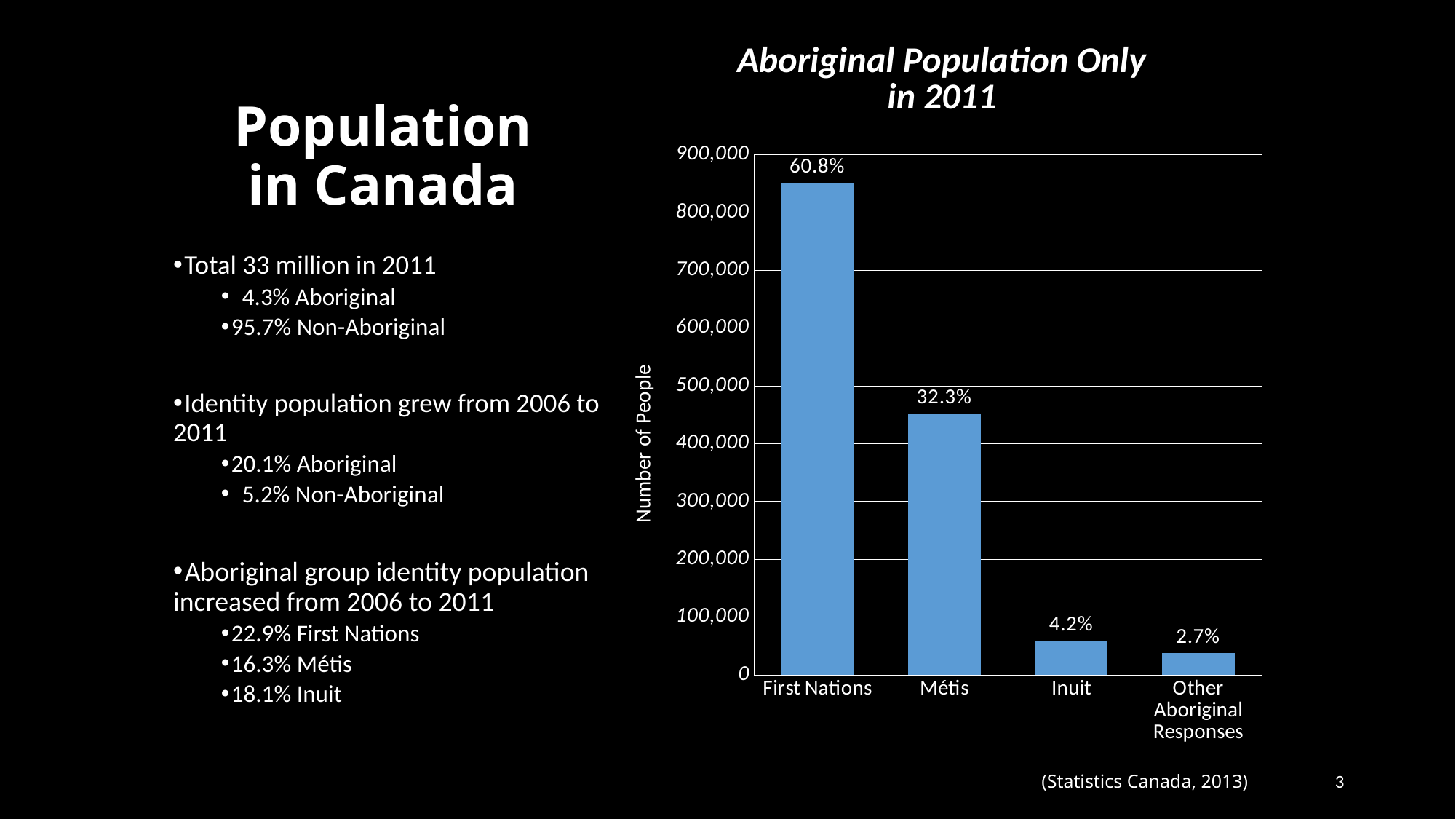
What data label is shown on the Métis bar? 32.3% What is the difference in percentage points between the First Nations label and the Métis label? 28.5 What data label is shown on the Inuit bar? 4.2% What type of chart is shown on the slide? Bar chart Which category has the tallest bar? First Nations What data label is shown on the Other Aboriginal Responses bar? 2.7% How many categories are shown on the x axis? 4 What data label is shown on the First Nations bar? 60.8% Which bar is taller, Inuit or Métis? Métis Which category has the shortest bar? Other Aboriginal Responses Is the value for First Nations greater or less than 800,000? greater Is the value for Inuit greater or less than 100,000? less